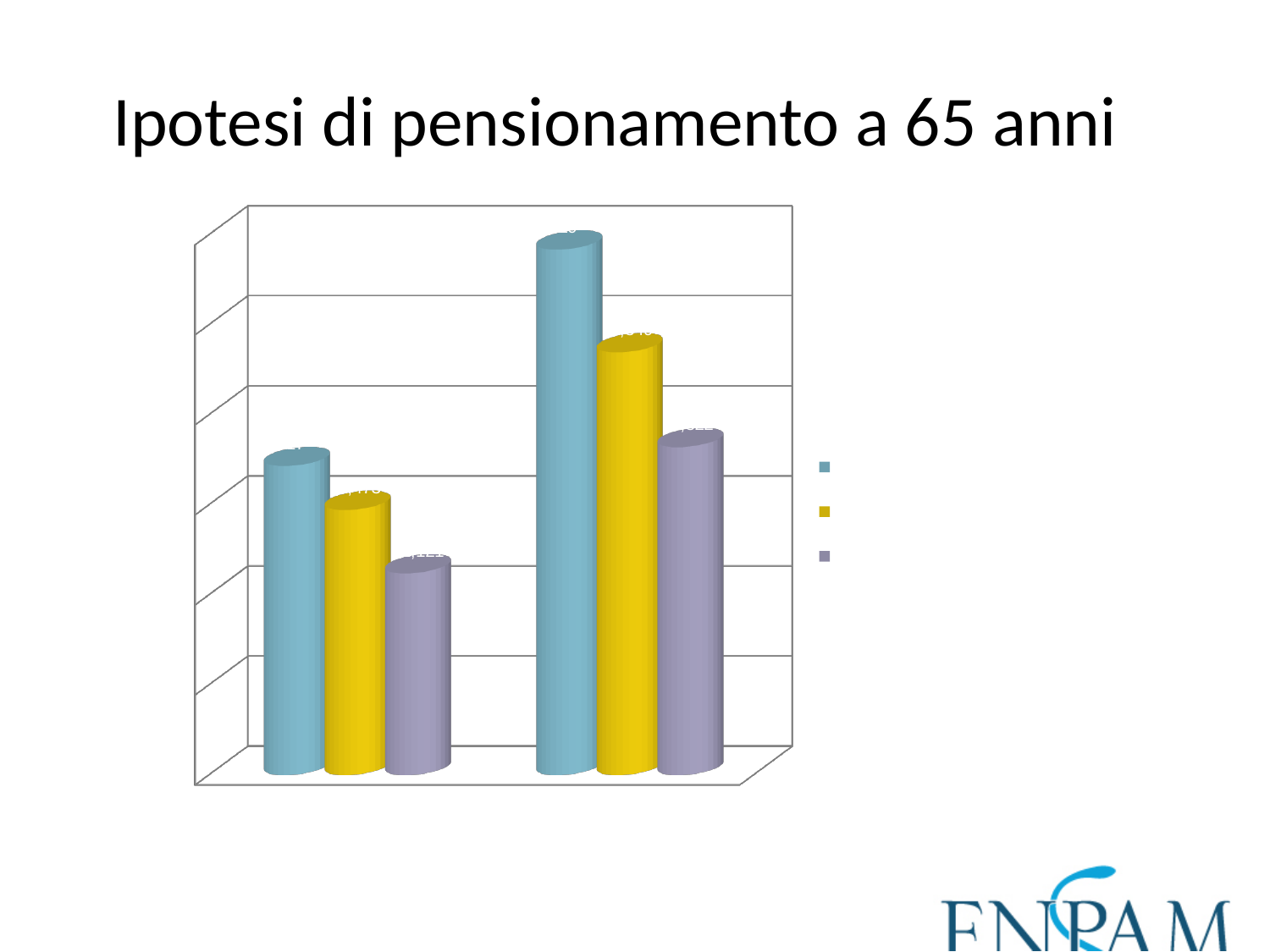
Which colour bar is the tallest in the left group of bars? blue Which colour bar is the shortest in the left group of bars? purple Which colour bar is the shortest in the right group of bars? purple Which colour bar is the tallest in the right group of bars? blue How many groups of bars (categories) are plotted along the x axis? 2 Which group of bars has the taller blue bar, the left group or the right group? right group What kind of chart is shown on the slide? bar chart Is the yellow bar in the right group taller or shorter than the yellow bar in the left group? taller How many series does the legend list? 3 What is the title of the slide containing the chart? Ipotesi di pensionamento a 65 anni Do the bar heights rise or fall from the left group to the right group? rise How many bars are plotted in total on the chart? 6